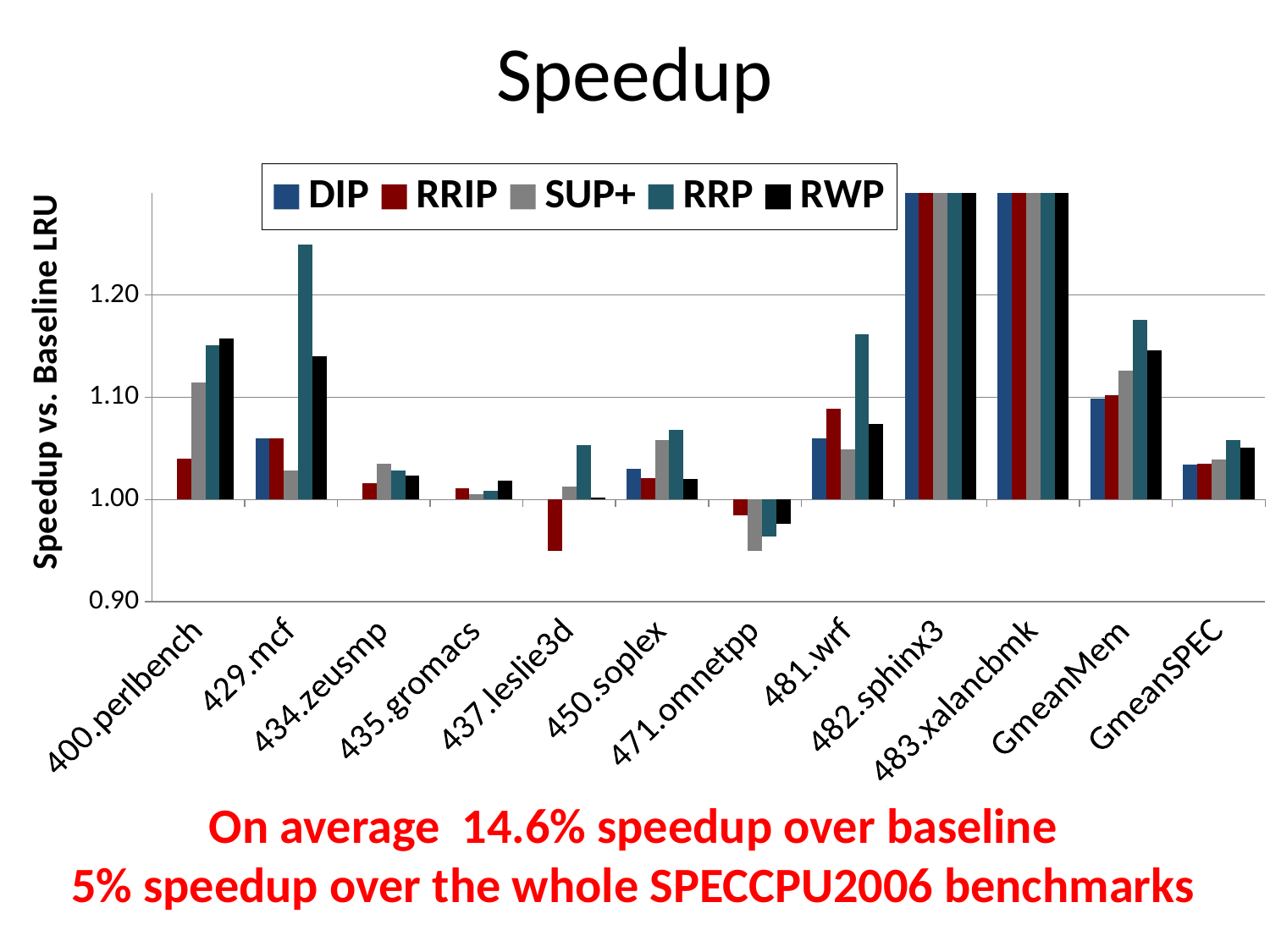
Is the RRP value for 481.wrf greater or less than 1.10? greater Is the SUP+ value for 471.omnetpp greater or less than 1.00? less Which series has the lowest value for 437.leslie3d? RRIP What kind of chart is shown on the slide? bar chart How many benchmark categories are shown on the x axis? 12 What is the title of the chart? Speedup Which series has the highest value for 429.mcf? RRP What is the label of the vertical axis? Speedup vs. Baseline LRU How many series does the legend list? 5 Is the RRIP value for 437.leslie3d greater or less than 1.00? less For 481.wrf, which is larger, the RRP value or the RRIP value? RRP